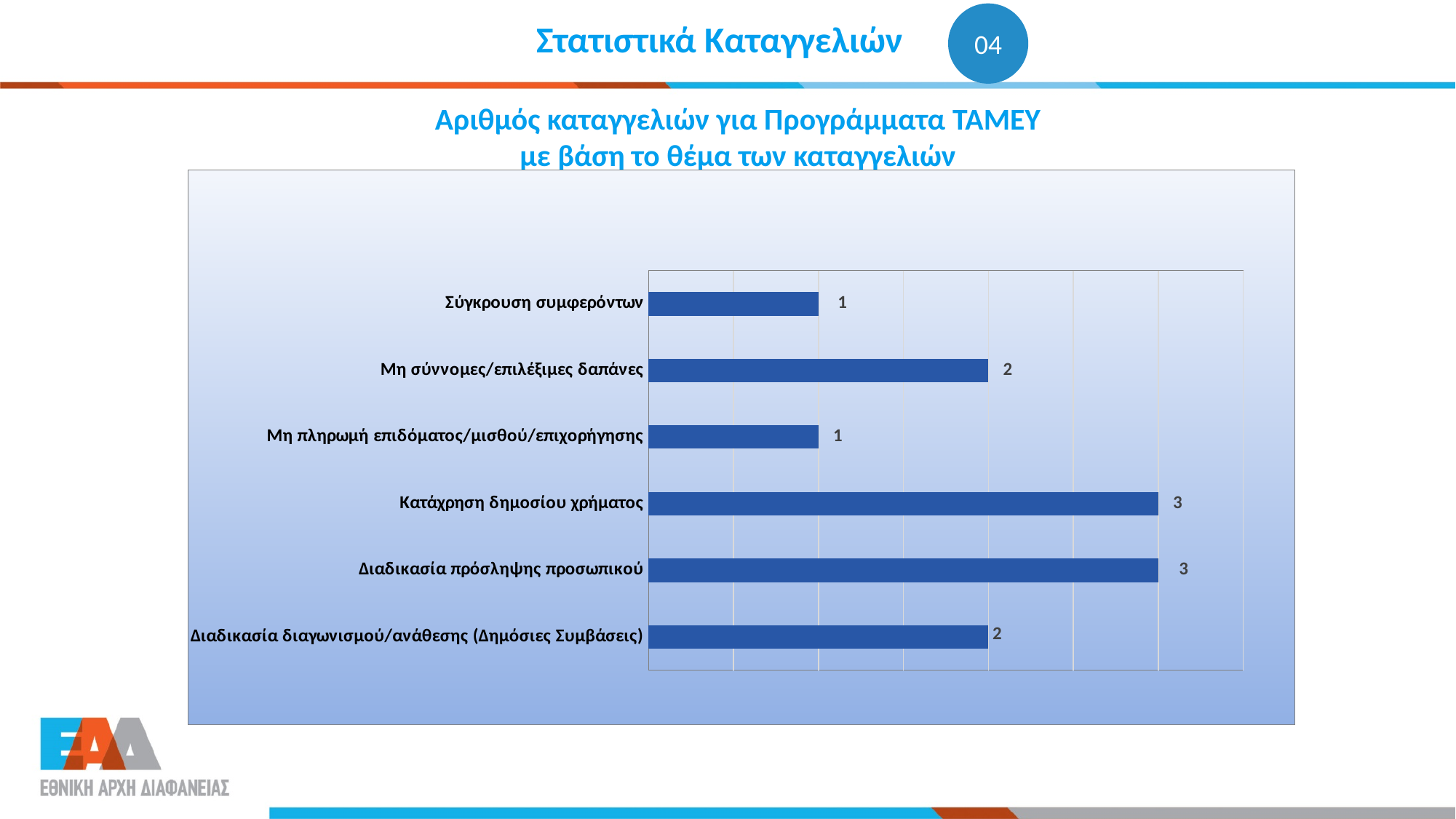
What is the highest value shown in the chart? 3 What is the value for Κατάχρηση δημοσίου χρήματος? 3 What is the value for Διαδικασία διαγωνισμού/ανάθεσης (Δημόσιες Συμβάσεις)? 2 Which has a larger value: Διαδικασία πρόσληψης προσωπικού or Μη σύννομες/επιλέξιμες δαπάνες? Διαδικασία πρόσληψης προσωπικού How many categories are shown in the chart? 6 What is the lowest value shown in the chart? 1 What is the difference between the values for Κατάχρηση δημοσίου χρήματος and Σύγκρουση συμφερόντων? 2 What kind of chart is shown on the slide? Bar chart What is the title of the chart? Αριθμός καταγγελιών για Προγράμματα ΤΑΜΕΥ με βάση το θέμα των καταγγελιών What is the value for Μη σύννομες/επιλέξιμες δαπάνες? 2 What is the value for Σύγκρουση συμφερόντων? 1 What is the value for Μη πληρωμή επιδόματος/μισθού/επιχορήγησης? 1